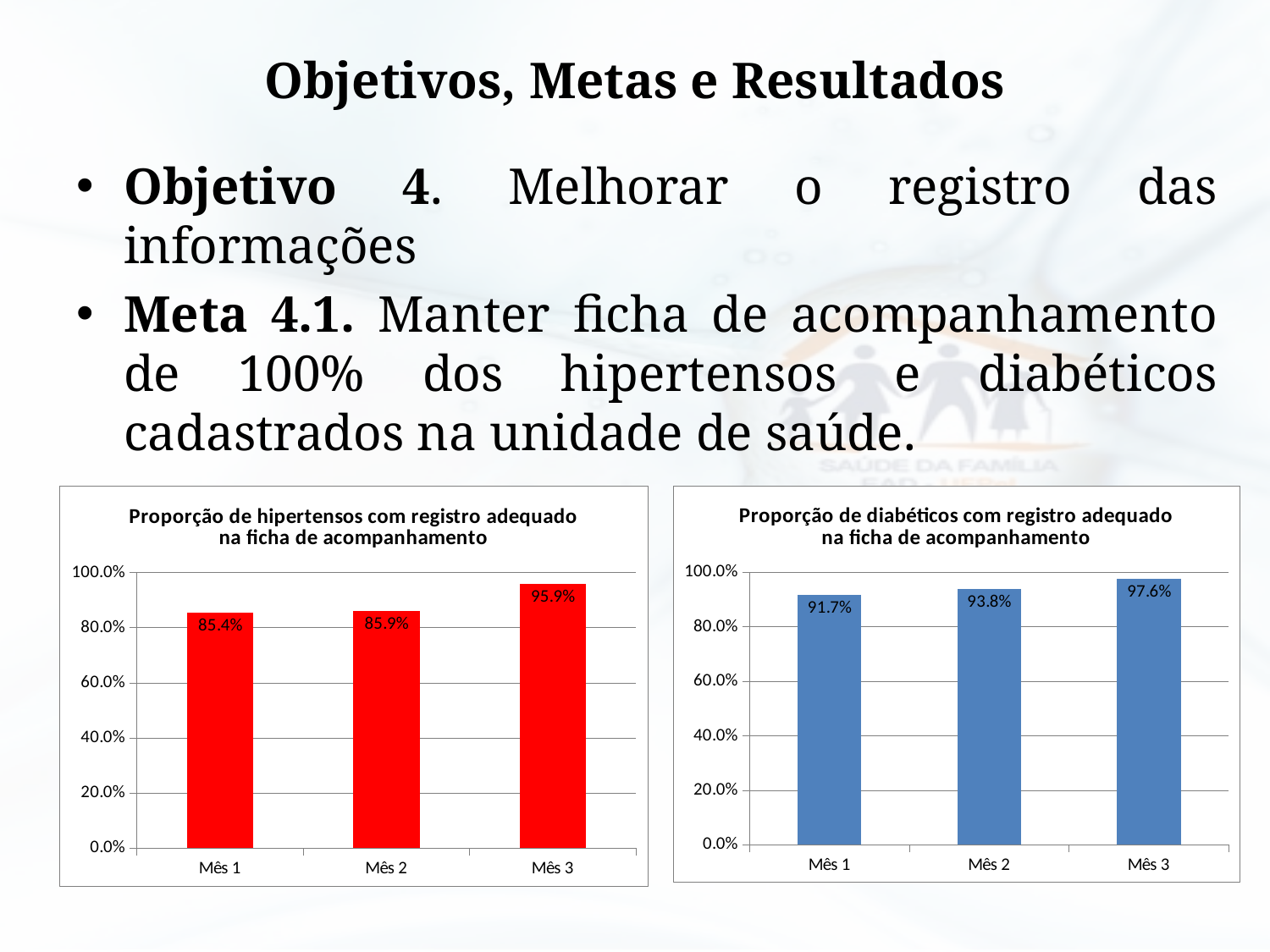
In the chart 'Proporção de diabéticos com registro adequado na ficha de acompanhamento', what is the value for Mês 3? 97.6% In the chart 'Proporção de diabéticos com registro adequado na ficha de acompanhamento', which month has the lowest value? Mês 1 Is the value for Mês 1 in the chart 'Proporção de diabéticos com registro adequado na ficha de acompanhamento' larger than the value for Mês 1 in the chart 'Proporção de hipertensos com registro adequado na ficha de acompanhamento'? Yes In the chart 'Proporção de hipertensos com registro adequado na ficha de acompanhamento', what is the value for Mês 3? 95.9% In the chart 'Proporção de hipertensos com registro adequado na ficha de acompanhamento', what is the value for Mês 1? 85.4% In the chart 'Proporção de diabéticos com registro adequado na ficha de acompanhamento', what is the difference between the values for Mês 3 and Mês 1? 5.9% In the chart 'Proporção de diabéticos com registro adequado na ficha de acompanhamento', what is the value for Mês 2? 93.8% In the chart 'Proporção de hipertensos com registro adequado na ficha de acompanhamento', what is the difference between the values for Mês 3 and Mês 1? 10.5% What kind of chart is the chart 'Proporção de diabéticos com registro adequado na ficha de acompanhamento'? Bar chart In the chart 'Proporção de hipertensos com registro adequado na ficha de acompanhamento', which month has the highest value? Mês 3 In the chart 'Proporção de diabéticos com registro adequado na ficha de acompanhamento', do the values rise or fall from Mês 1 to Mês 3? Rise How many months are shown in the chart 'Proporção de hipertensos com registro adequado na ficha de acompanhamento'? 3